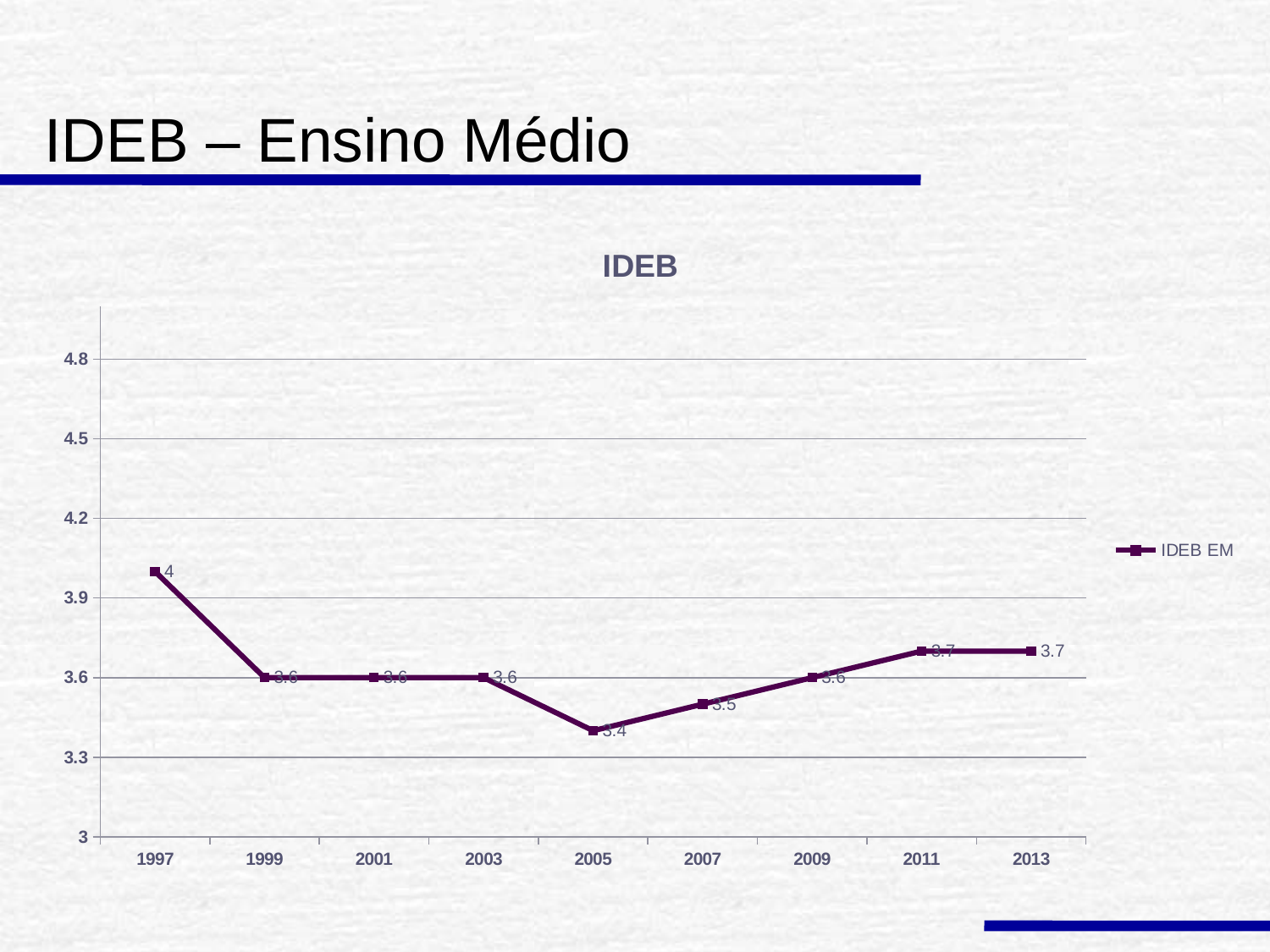
What is the IDEB EM value for 2005? 3.4 What is the difference between the IDEB EM value in 1997 and in 2005? 0.6 What is the IDEB EM value for 2007? 3.5 What is the IDEB EM value for 2013? 3.7 Which year has the lowest IDEB EM value? 2005 How many years are plotted on the x axis? 9 What is the title of the chart? IDEB What is the IDEB EM value for 1997? 4 Which year has a larger IDEB EM value, 2009 or 2011? 2011 What kind of chart is shown? line chart Is the IDEB EM value for 1997 greater or less than 3.9? greater Which year has the highest IDEB EM value? 1997